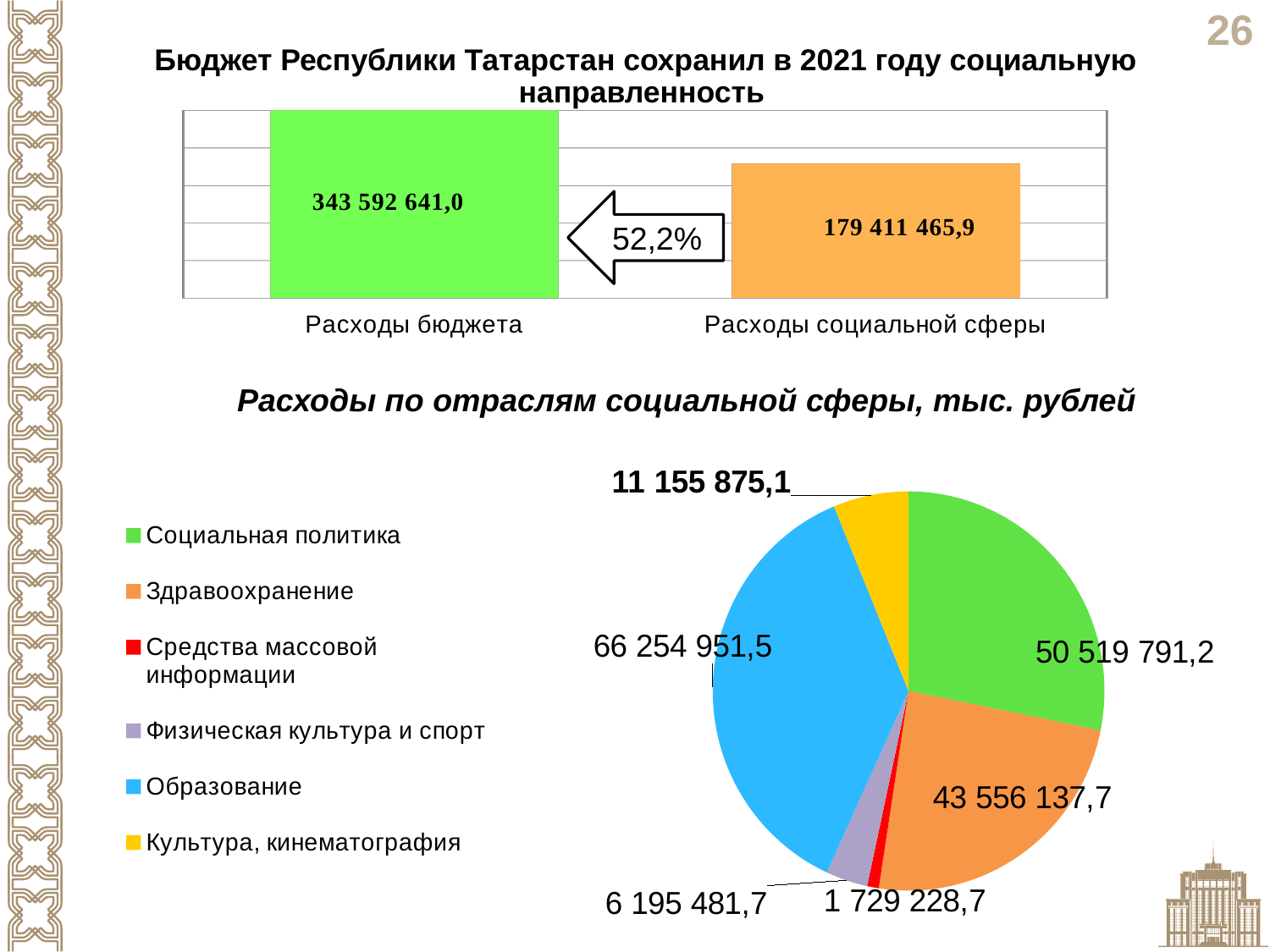
On the pie chart Расходы по отраслям социальной сферы, which category has the largest value? Образование On the pie chart Расходы по отраслям социальной сферы, what is the value for Здравоохранение? 43 556 137,7 On the top bar chart, what percentage is shown on the arrow between the two bars? 52,2% On the pie chart Расходы по отраслям социальной сферы, how many categories does the legend list? 6 On the top bar chart, what is the difference between Расходы бюджета and Расходы социальной сферы? 164 181 175,1 What kind of chart is the top chart on the slide? bar chart On the top bar chart, what is the value for Расходы бюджета? 343 592 641,0 On the pie chart Расходы по отраслям социальной сферы, which is larger: Социальная политика or Здравоохранение? Социальная политика On the pie chart Расходы по отраслям социальной сферы, what is the difference between Образование and Социальная политика? 15 735 160,3 On the pie chart Расходы по отраслям социальной сферы, which category has the smallest value? Средства массовой информации On the top bar chart, what is the value for Расходы социальной сферы? 179 411 465,9 On the pie chart Расходы по отраслям социальной сферы, what is the value for Образование? 66 254 951,5